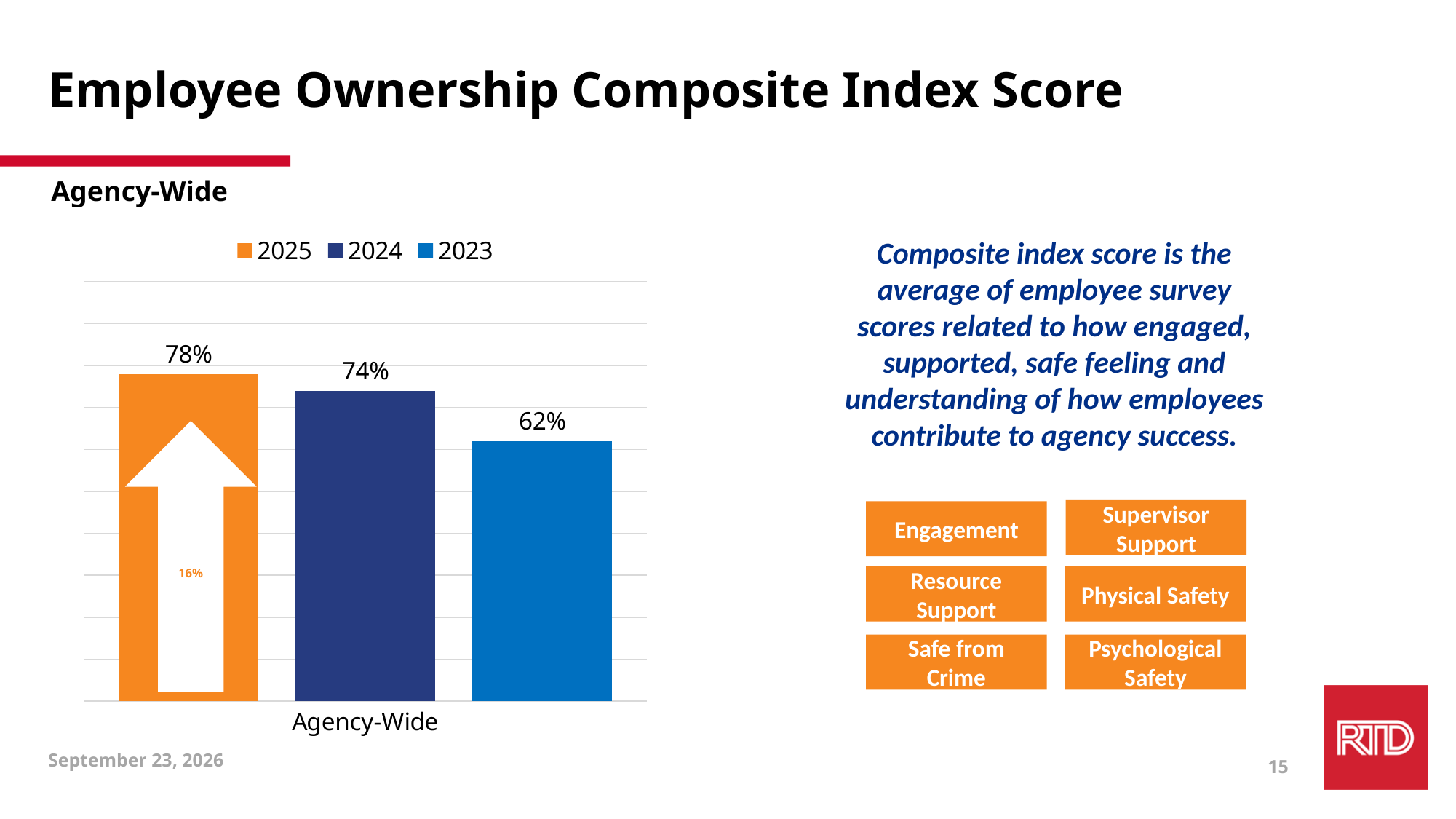
What is the Agency-Wide composite index score for 2025? 78% Which year has the highest Agency-Wide composite index score? 2025 Which year has the lowest Agency-Wide composite index score? 2023 What kind of chart is shown on the slide? Bar chart Which series is shown in orange in the legend? 2025 What is the difference between the 2025 and 2024 Agency-Wide scores? 4% What is the difference between the 2025 and 2023 Agency-Wide scores? 16% Which is larger, the 2024 score or the 2023 score? 2024 What is the Agency-Wide composite index score for 2024? 74% What is the category label on the x axis of the chart? Agency-Wide What is the Agency-Wide composite index score for 2023? 62% How many series does the legend list? 3